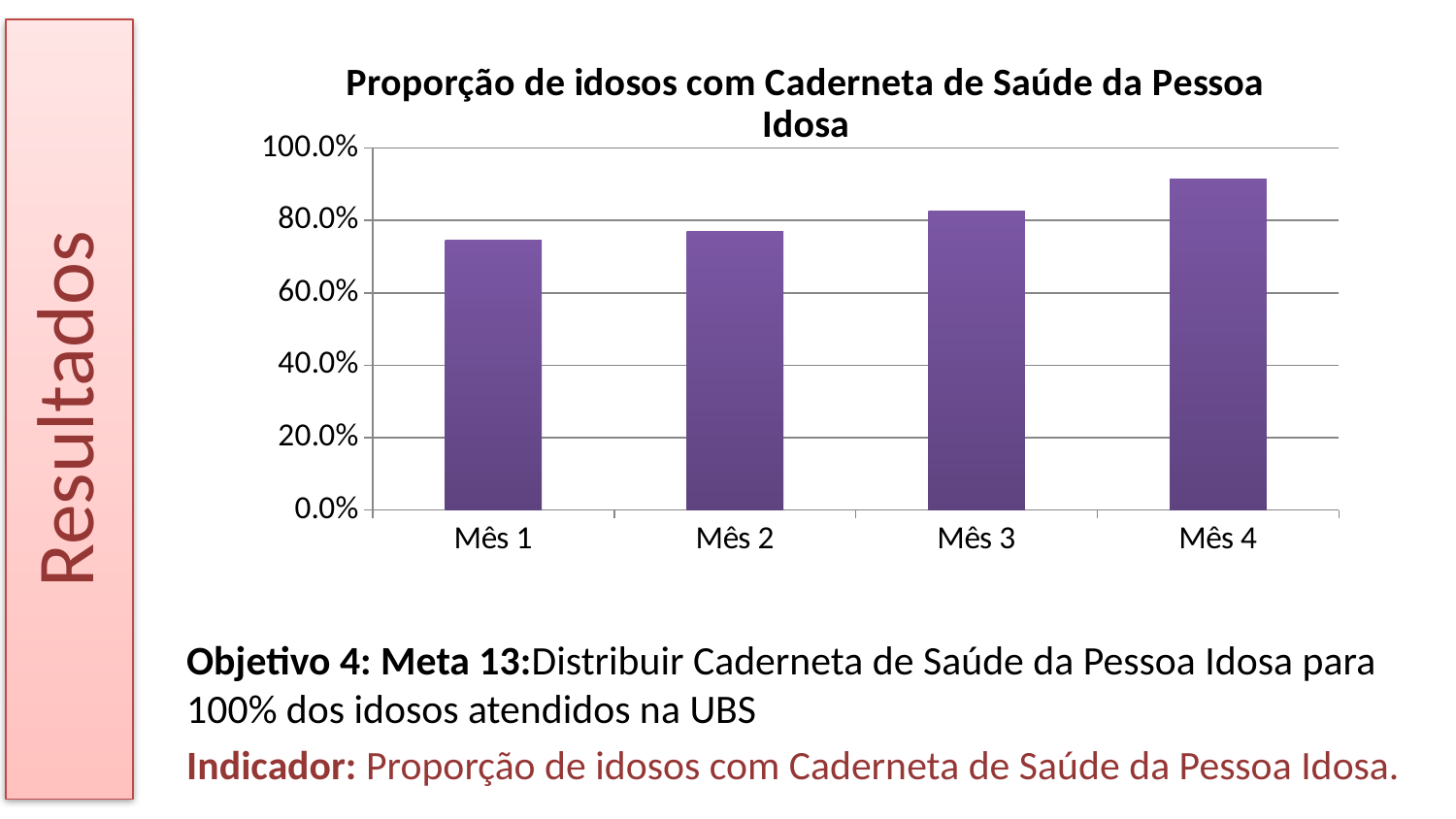
Is the value for Mês 4 greater or less than 100.0%? less Is the value for Mês 2 greater or less than 80.0%? less How many months (categories) are plotted in the chart? 4 Is the value for Mês 4 greater or less than 80.0%? greater What is the title of the chart? Proporção de idosos com Caderneta de Saúde da Pessoa Idosa Which is larger, the value for Mês 3 or the value for Mês 4? Mês 4 Which is larger, the value for Mês 1 or the value for Mês 3? Mês 3 What kind of chart is shown on the slide? bar chart Which month has the highest proportion of elderly with the Caderneta de Saúde da Pessoa Idosa? Mês 4 Do the values rise or fall from Mês 1 to Mês 4? rise